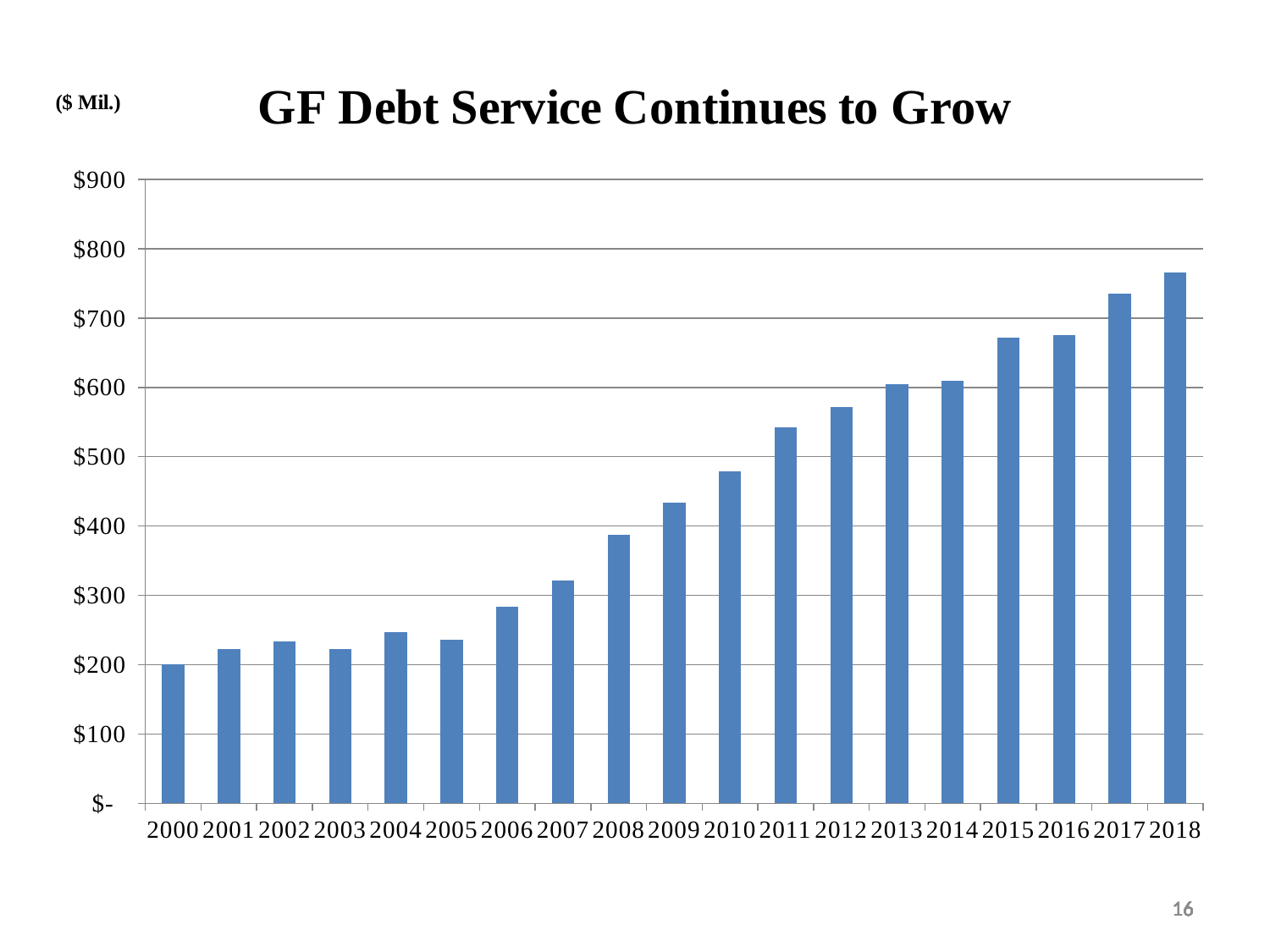
What is the title of the chart? GF Debt Service Continues to Grow Which year has the highest GF debt service? 2018 What type of chart is shown on the slide? bar chart Is the value for 2009 greater or less than $400? greater Is the value for 2010 greater or less than $500? less How many years are plotted on the x axis? 19 Which year has the larger value, 2017 or 2016? 2017 Is the value for 2015 greater or less than $600? greater Which year has the lowest GF debt service? 2000 Do the values generally rise or fall from 2000 to 2018? rise